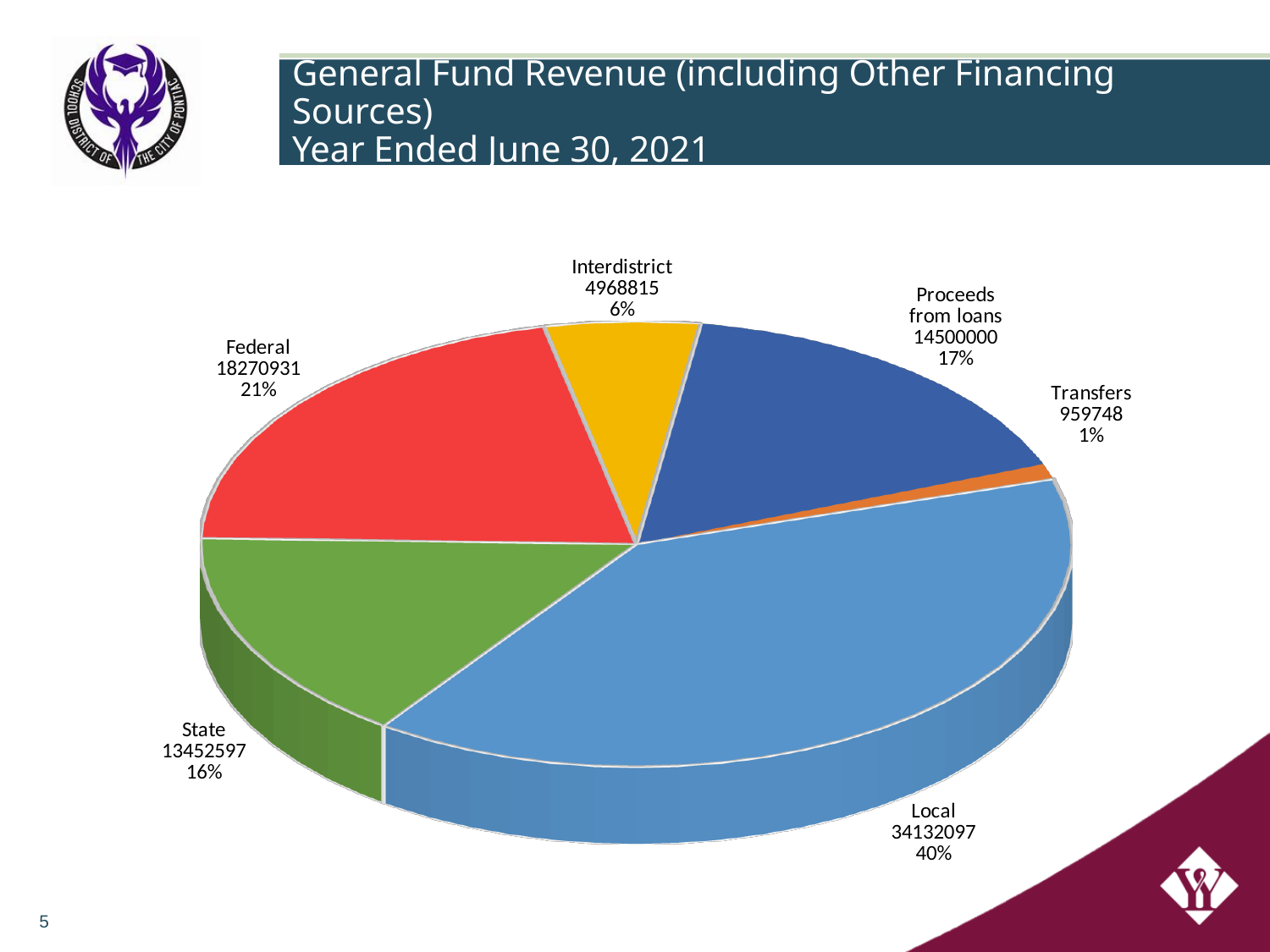
What is the title of the chart on the slide? General Fund Revenue (including Other Financing Sources) Year Ended June 30, 2021 What share of the pie does Interdistrict represent? 6% What is the value for Transfers? 959748 Which category has the smallest slice of the pie? Transfers What is the difference between the Federal and State values? 4818334 Which is larger, the value for State or the value for Proceeds from loans? Proceeds from loans Which category has the largest slice of the pie? Local What is the value for Proceeds from loans? 14500000 How many categories are shown in the pie chart? 6 What is the value for Federal? 18270931 What is the value for Local? 34132097 What kind of chart is shown on the slide? Pie chart